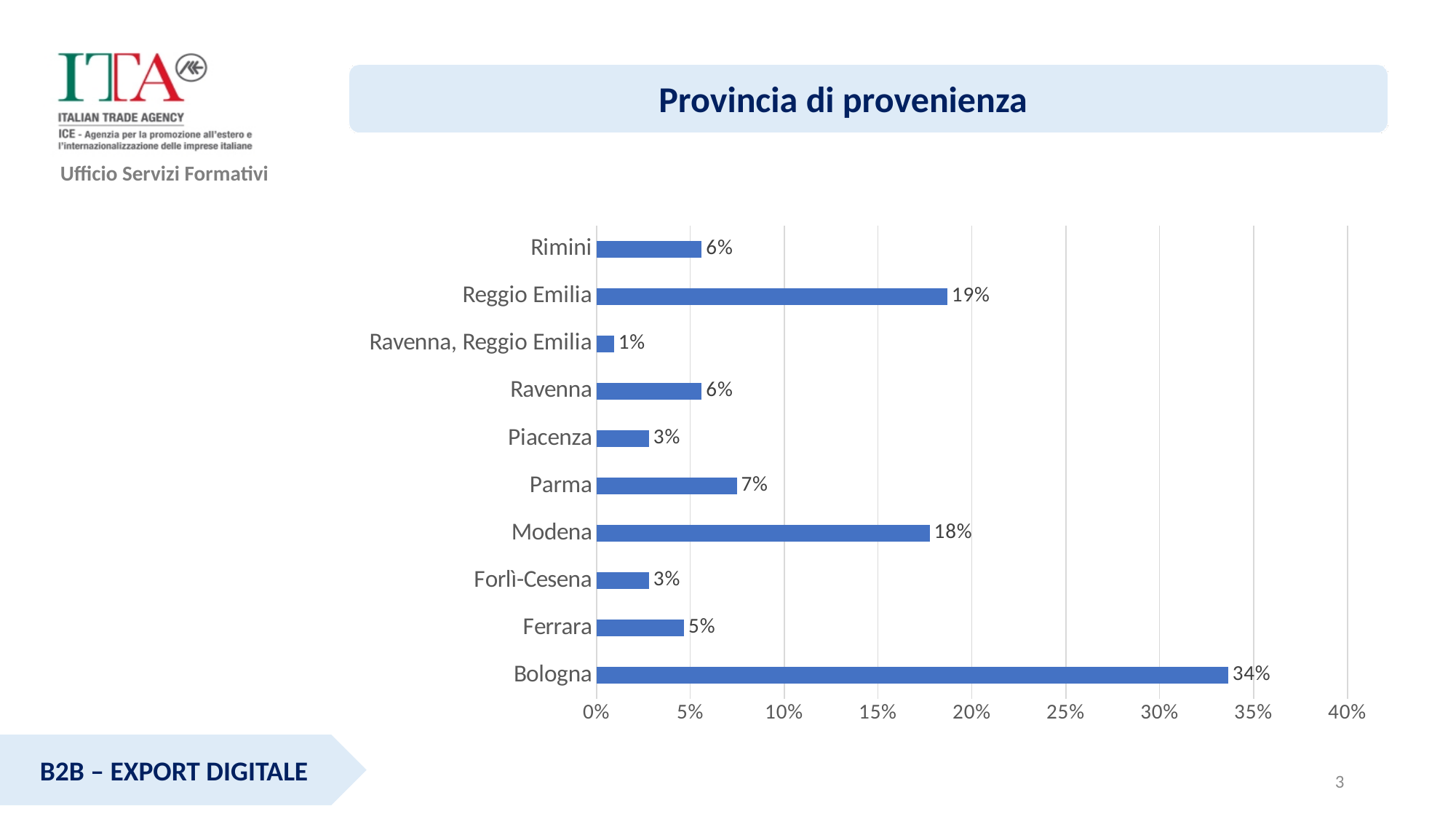
What is the value for Reggio Emilia? 19% What is the difference between the values for Bologna and Reggio Emilia? 15% What is the title of the chart? Provincia di provenienza What kind of chart is shown on the slide? Bar chart Which province has the highest value? Bologna Which category has the lowest value? Ravenna, Reggio Emilia What is the value for Ravenna, Reggio Emilia? 1% What is the value for Bologna? 34% Is the value for Modena greater or less than 20%? less Which is larger, the value for Parma or the value for Ferrara? Parma What is the value for Modena? 18% How many categories are shown in the chart? 10